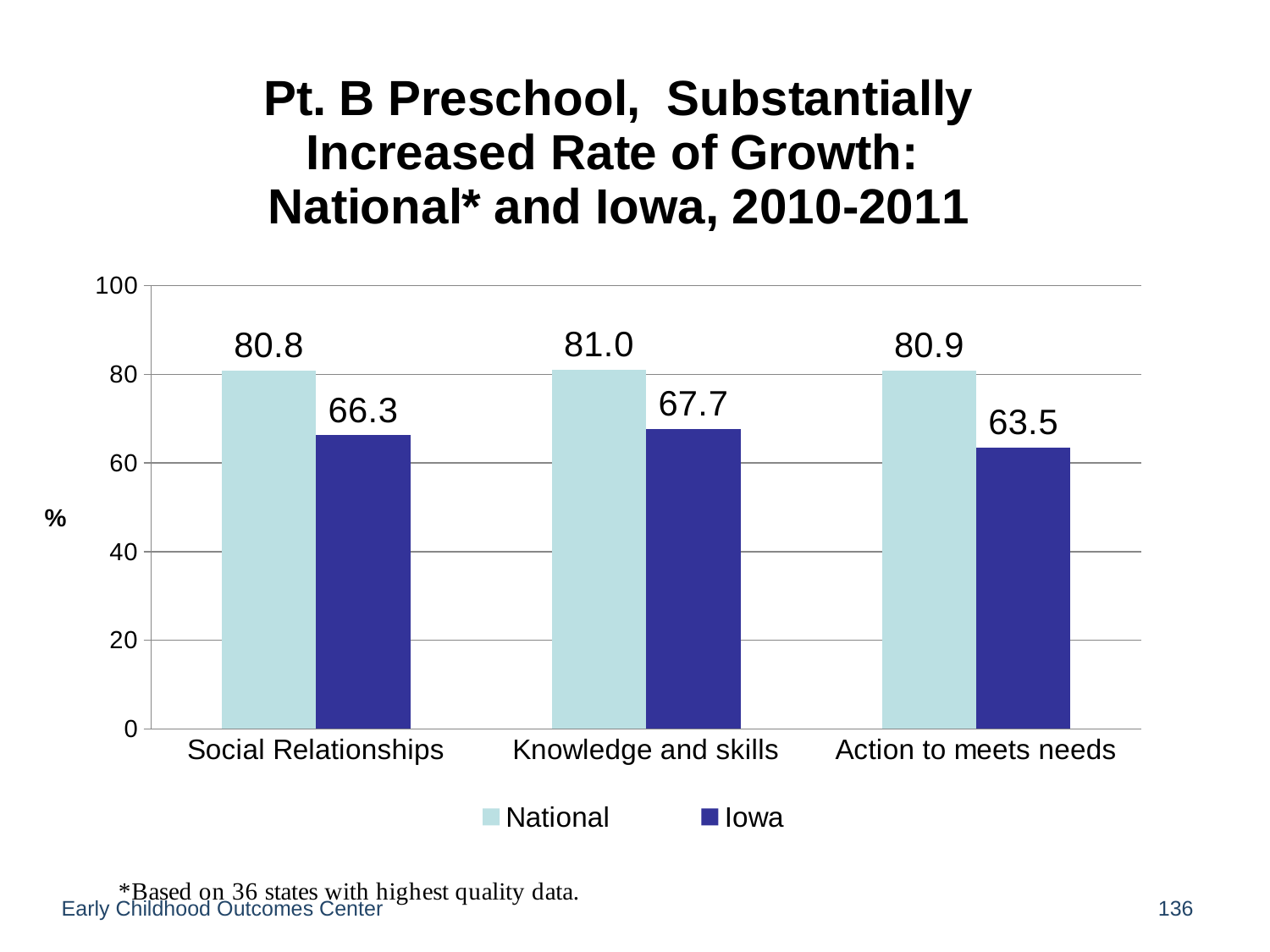
What is the Iowa value for Action to meets needs? 63.5 For Knowledge and skills, which is larger, the National value or the Iowa value? National Is the Iowa value for Social Relationships greater or less than 60? greater How many categories are shown on the x axis? 3 How many series does the legend list? 2 Which category has the lowest Iowa value? Action to meets needs What is the difference between the National and Iowa values for Action to meets needs? 17.4 What is the National value for Social Relationships? 80.8 What is the Iowa value for Knowledge and skills? 67.7 Which category has the highest Iowa value? Knowledge and skills What kind of chart is shown on the slide? bar chart What is the difference between the National and Iowa values for Social Relationships? 14.5